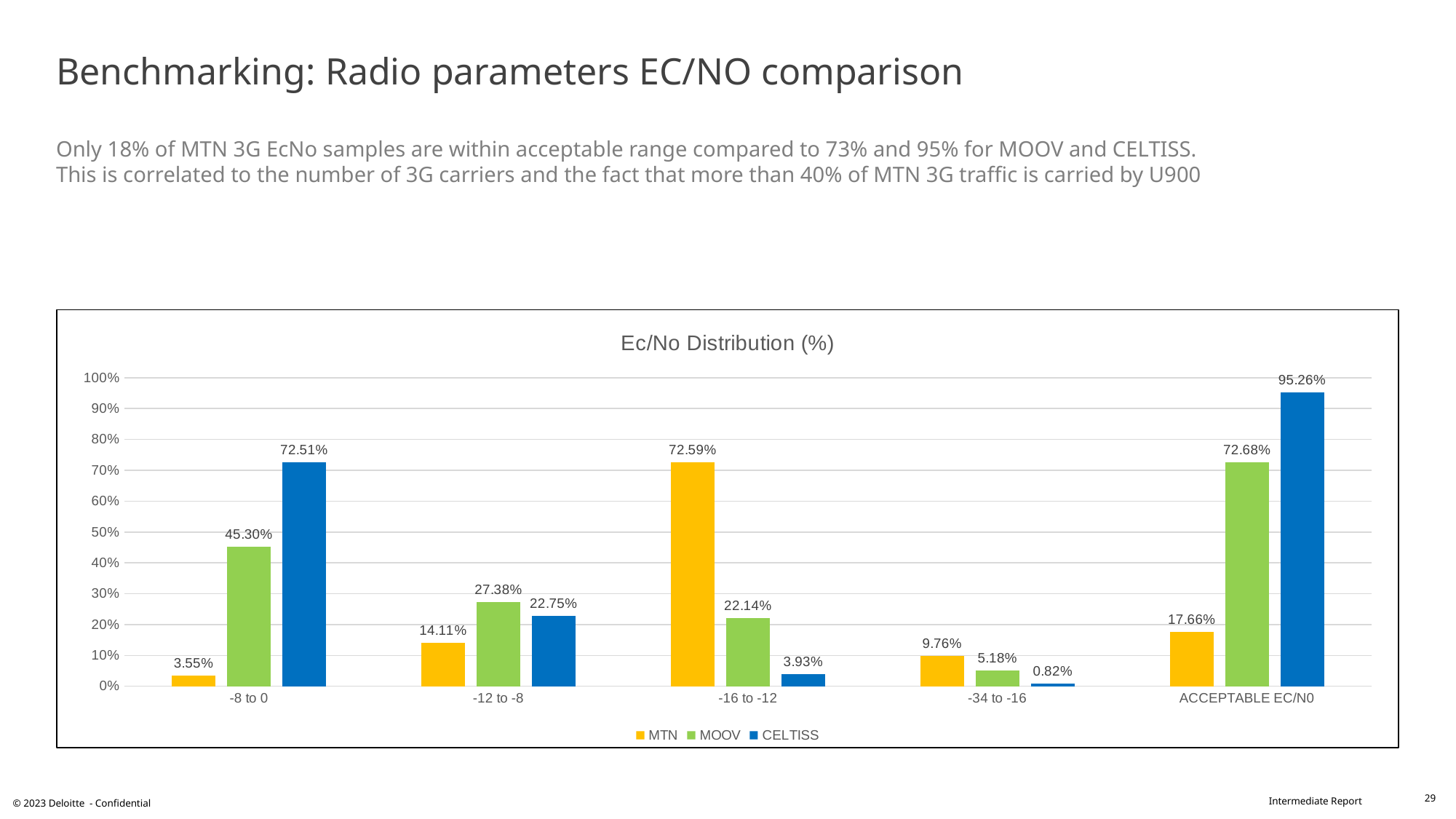
Which series has the highest value in the -34 to -16 category? MTN Is the value for MOOV in the ACCEPTABLE EC/N0 category greater or less than 70%? greater What is the title of the chart? Ec/No Distribution (%) What is the value for MOOV in the -8 to 0 category? 45.30% What is the value for CELTISS in the ACCEPTABLE EC/N0 category? 95.26% In the -12 to -8 category, which is larger: the MOOV value or the CELTISS value? MOOV What kind of chart is shown on the slide? Bar chart What is the difference between the CELTISS and MTN values in the ACCEPTABLE EC/N0 category? 77.60% What is the value for MTN in the -16 to -12 category? 72.59% How many categories are shown on the x axis? 5 How many series does the legend list? 3 Which series has the lowest value in the -8 to 0 category? MTN